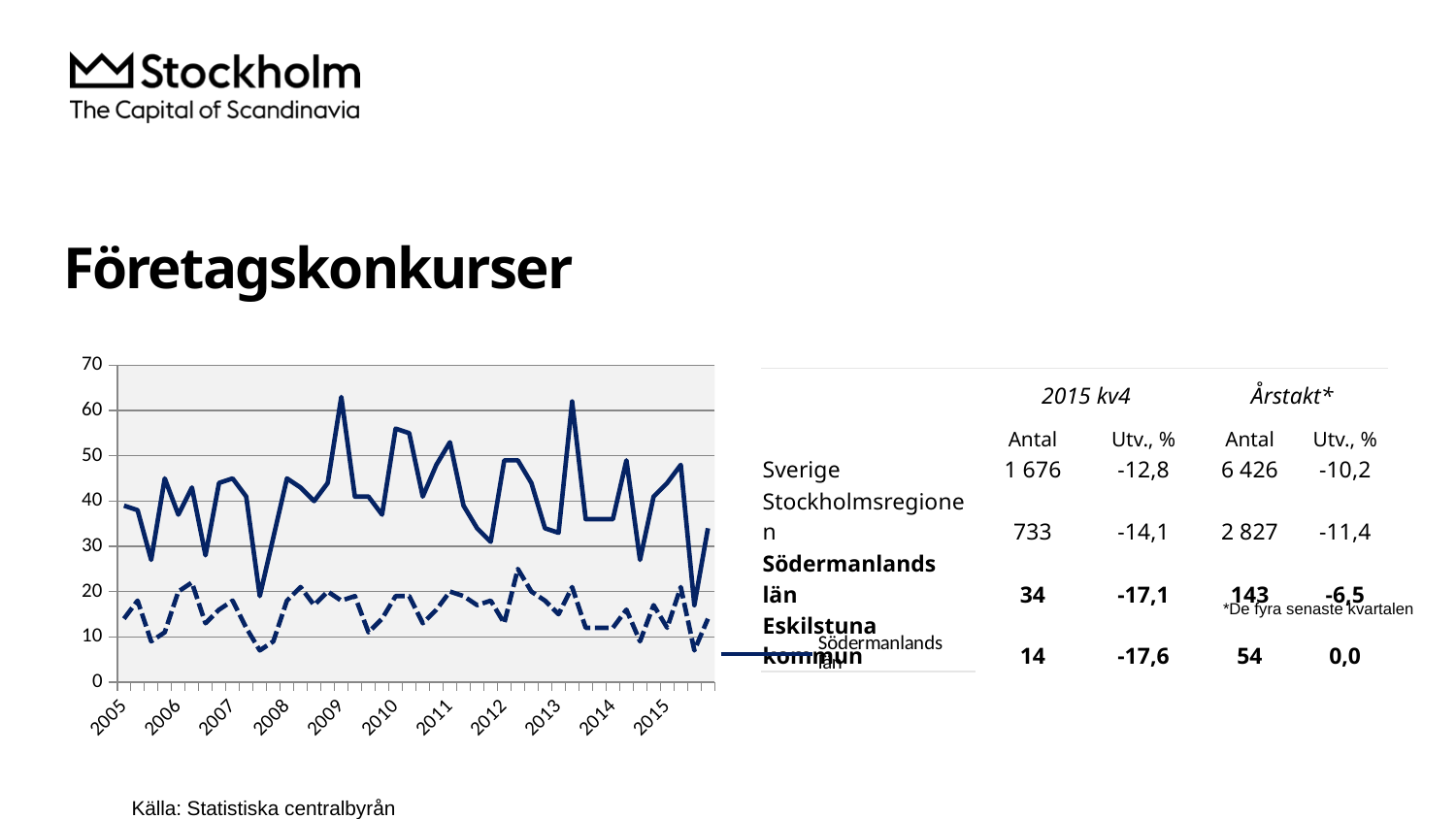
Is the peak of the solid line in 2009 greater or less than 60? greater What kind of chart is shown on the slide? line chart Is the dashed line ever greater than 30 at any point in the chart? no Which series does the solid line in the chart represent, according to the legend? Södermanlands län Is the value of the dashed line at the start of 2005 greater or less than 20? less Which line has higher values throughout the chart, the solid line or the dashed line? the solid line What is the first year shown on the x axis of the chart? 2005 What is the highest value shown on the y axis of the chart? 70 How many lines (series) are plotted in the chart? 2 How many year labels are shown on the x axis of the chart? 11